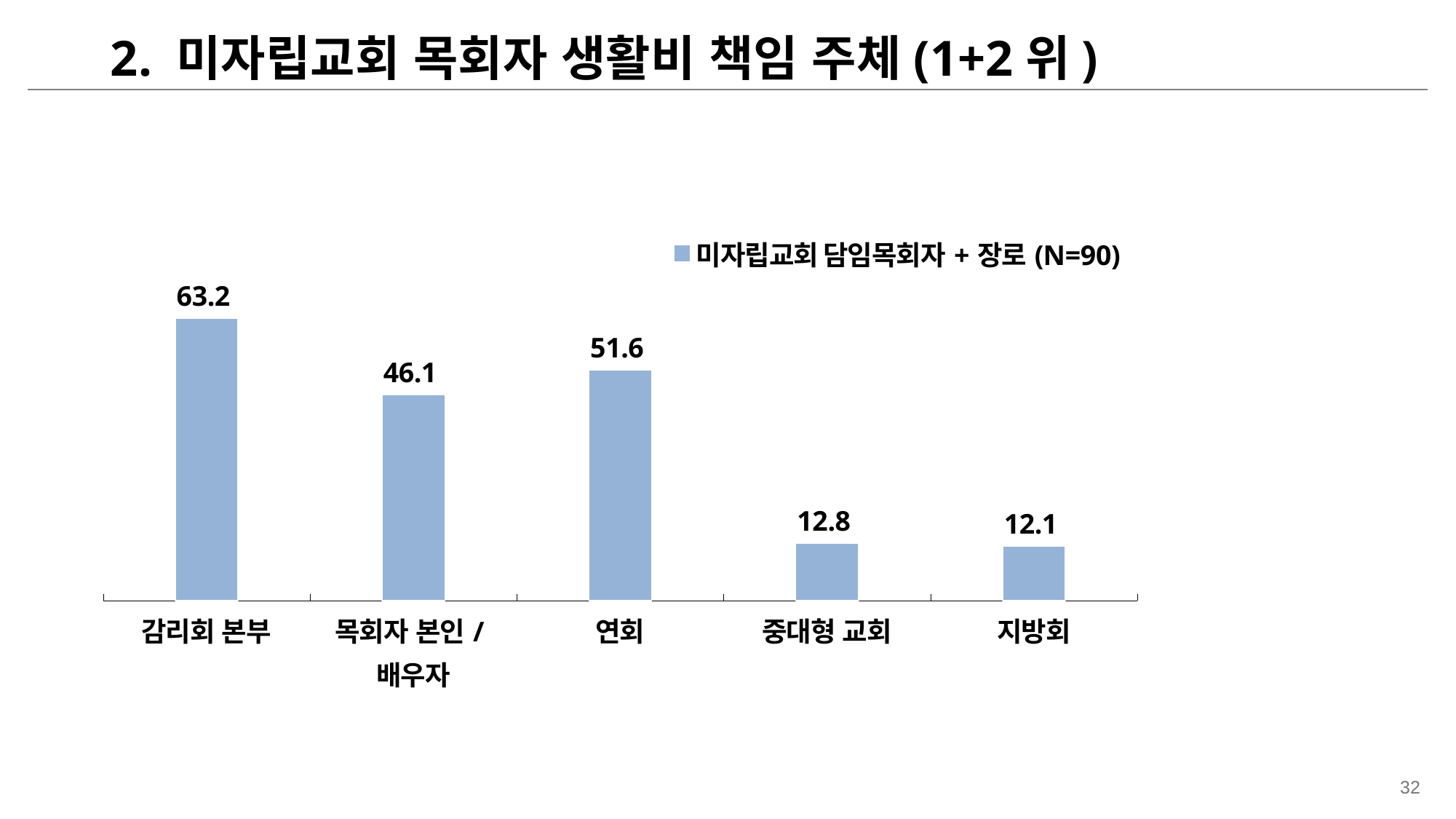
What is the value for 지방회? 12.1 What is the value for 중대형 교회? 12.8 What is the difference between the values for 감리회 본부 and 연회? 11.6 What is the legend entry for the series shown? 미자립교회 담임목회자 + 장로 (N=90) Which category has the highest value? 감리회 본부 What is the value for 연회? 51.6 Which category has the lowest value? 지방회 What kind of chart is shown on the slide? bar chart How many categories are shown on the x axis? 5 What is the value for 목회자 본인 / 배우자? 46.1 Which is larger, the value for 연회 or the value for 목회자 본인 / 배우자? 연회 What is the value for 감리회 본부? 63.2